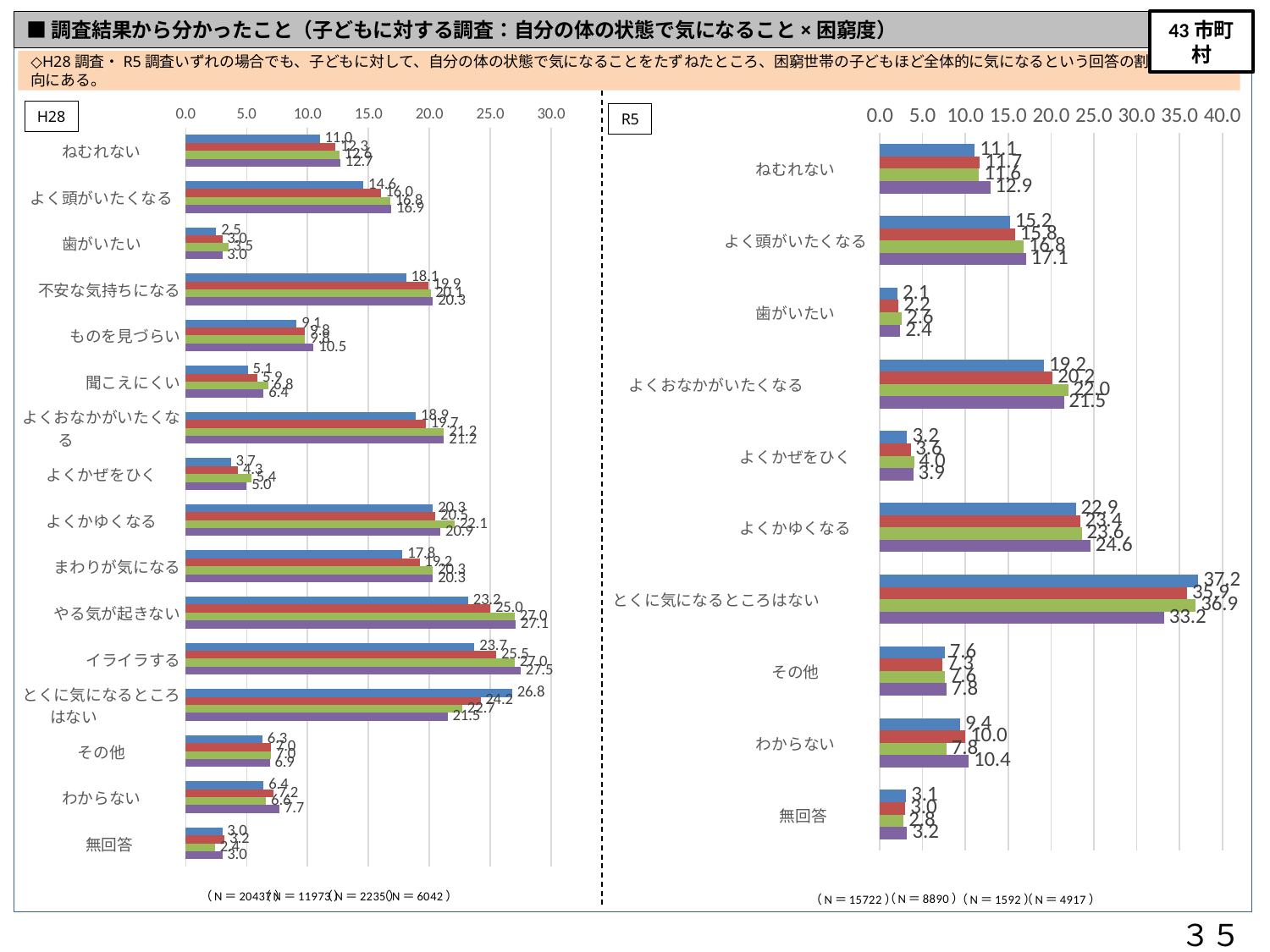
On the R5 chart, what is the value of the purple bar for ねむれない? 12.9 On the H28 chart, which has the larger blue bar: よくかゆくなる or まわりが気になる? よくかゆくなる How many categories are shown on the H28 chart on the left? 16 On the H28 chart, what is the value of the blue bar for とくに気になるところはない? 26.8 How many categories are shown on the R5 chart on the right? 10 On the R5 chart, what is the difference between the purple bar and the blue bar for よくかゆくなる? 1.7 On the R5 chart, which category has the highest blue bar? とくに気になるところはない On the R5 chart, what is the value of the blue bar for とくに気になるところはない? 37.2 On the H28 chart, is the value of the purple bar for イライラする greater or less than 25.0? greater On the R5 chart, which category has the lowest blue bar? 歯がいたい What kind of chart is the R5 chart on the right side of the slide? bar chart On the R5 chart, what is the difference between the blue bar and the purple bar for とくに気になるところはない? 4.0